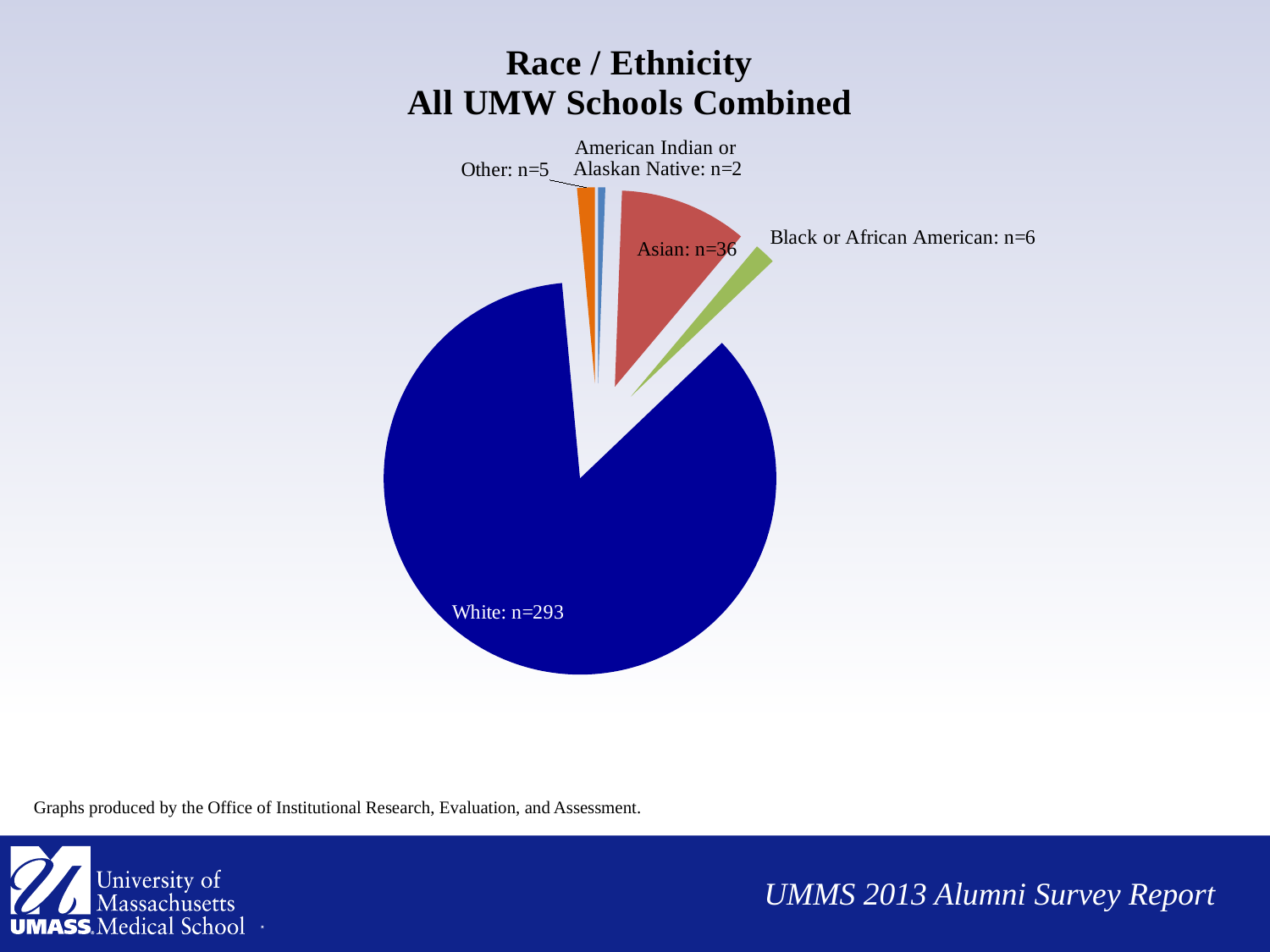
How many race/ethnicity categories are shown in the pie chart? 5 What is the value (n) for Asian in the pie chart? n=36 What is the value (n) for American Indian or Alaskan Native in the pie chart? n=2 What is the value (n) for Black or African American in the pie chart? n=6 What is the value (n) for White in the Race / Ethnicity pie chart? n=293 What is the title of the chart? Race / Ethnicity All UMW Schools Combined Which is larger, the Asian slice or the Black or African American slice? Asian What kind of chart is shown on the slide? Pie chart How many more respondents are White than Asian? 257 Which race/ethnicity category has the smallest slice of the pie? American Indian or Alaskan Native Which race/ethnicity category has the largest slice of the pie? White What is the total number of respondents across all slices of the pie chart? 342